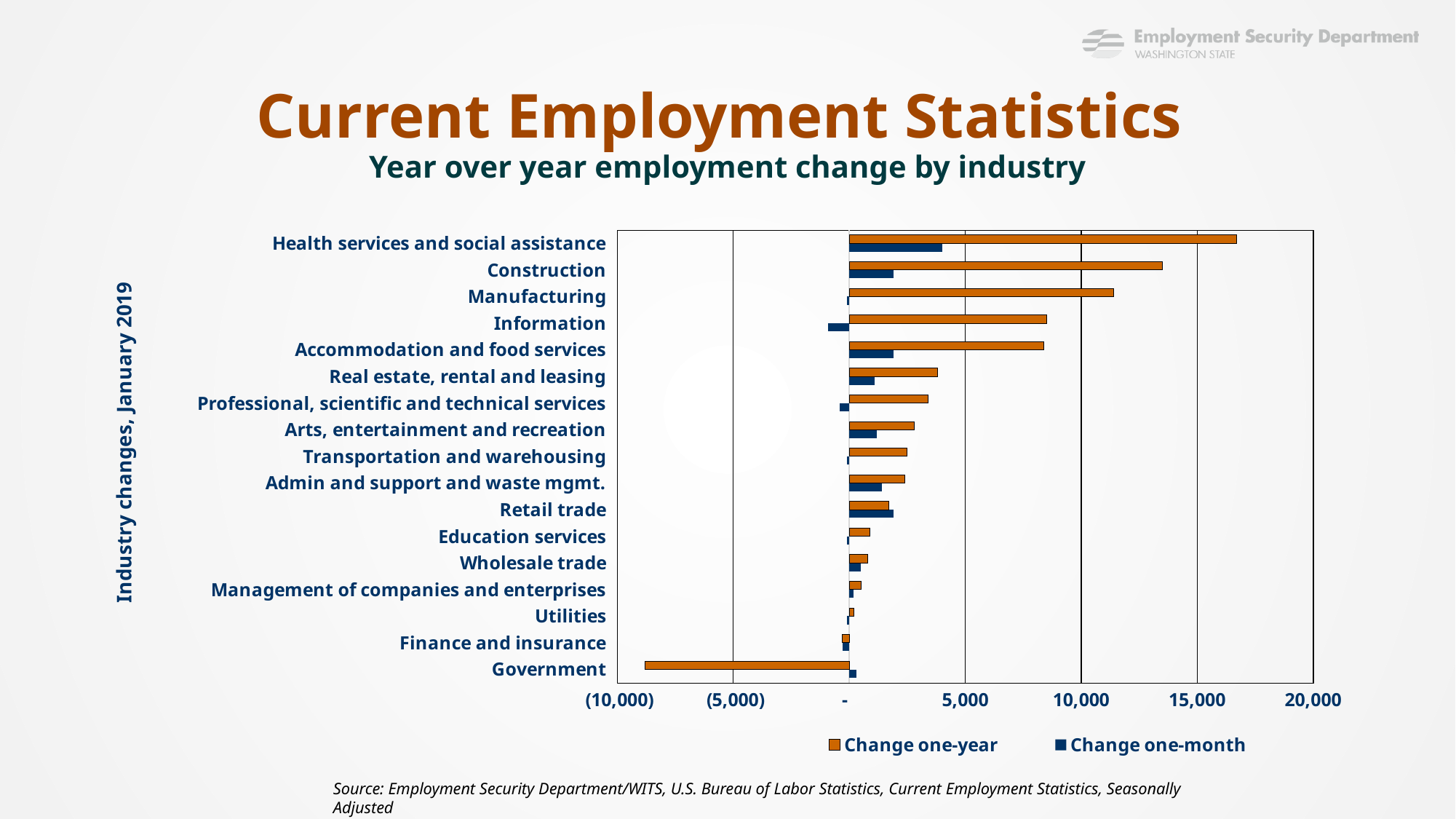
Which industry has the lowest one-month employment change? Information Is the one-year change for Information greater or less than 10,000? less What kind of chart is shown on the slide? bar chart How many industries are listed on the chart? 17 Which industry has the largest one-month employment change? Health services and social assistance Is the one-year change for Government greater or less than (5,000)? less Which industry has the lowest one-year employment change? Government Which has the larger one-year change, Construction or Manufacturing? Construction What are the two series named in the legend? Change one-year and Change one-month How many series does the legend list? 2 Is the one-year change for Health services and social assistance greater or less than 15,000? greater Which industry has the highest one-year employment change? Health services and social assistance